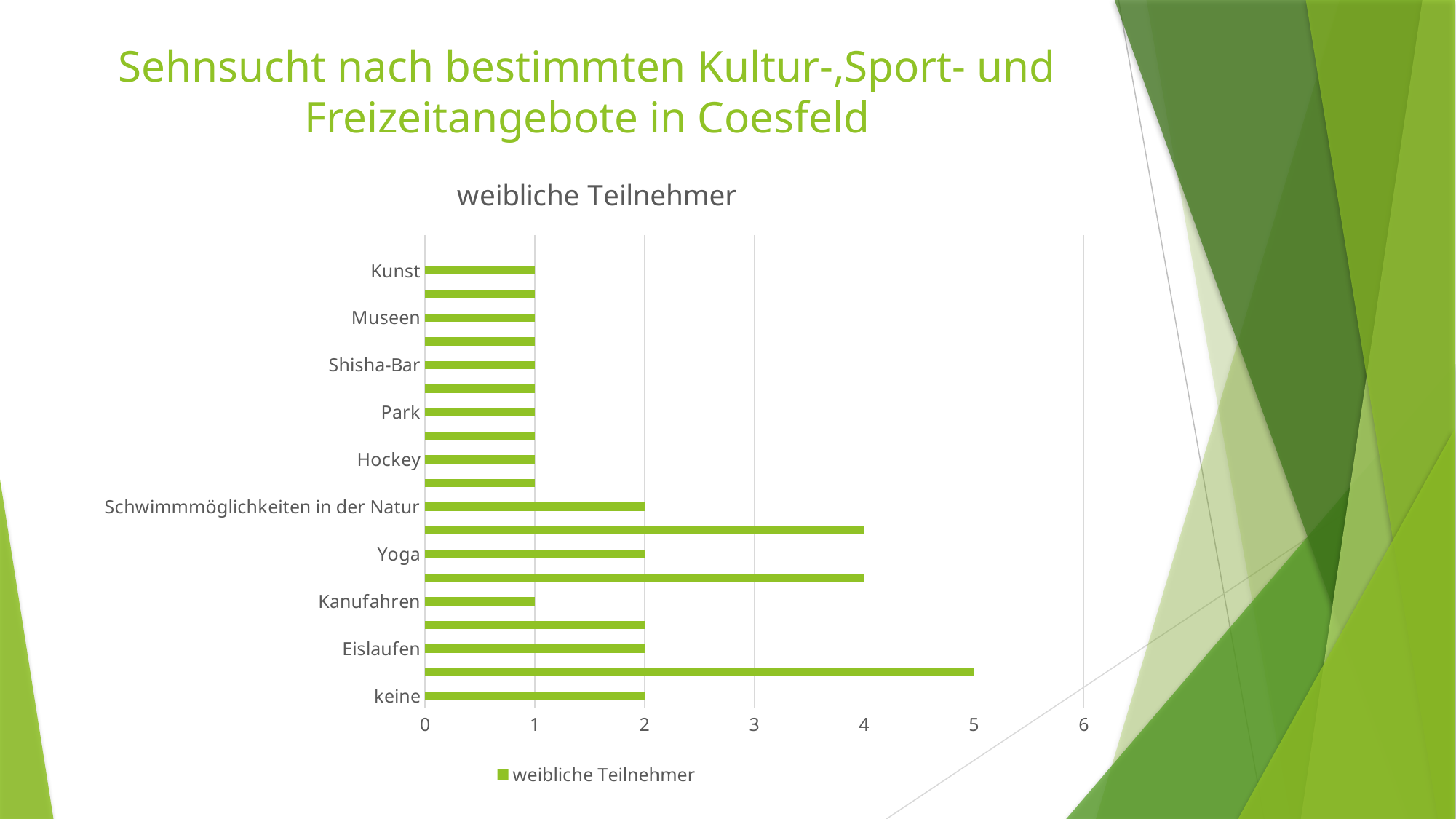
What is the value for keine? 2 How many series does the legend list? 1 What is the value for Schwimmmöglichkeiten in der Natur? 2 What is the title of the chart? weibliche Teilnehmer What is the largest value reached by any bar in the chart? 5 What kind of chart is shown on the slide? bar chart What is the value for Yoga? 2 What is the value for Kanufahren? 1 Which is larger, the value for Yoga or the value for Park? Yoga What is the value for Kunst? 1 Is the value for keine greater or less than 1? greater What is the difference between the value for Eislaufen and the value for Kanufahren? 1